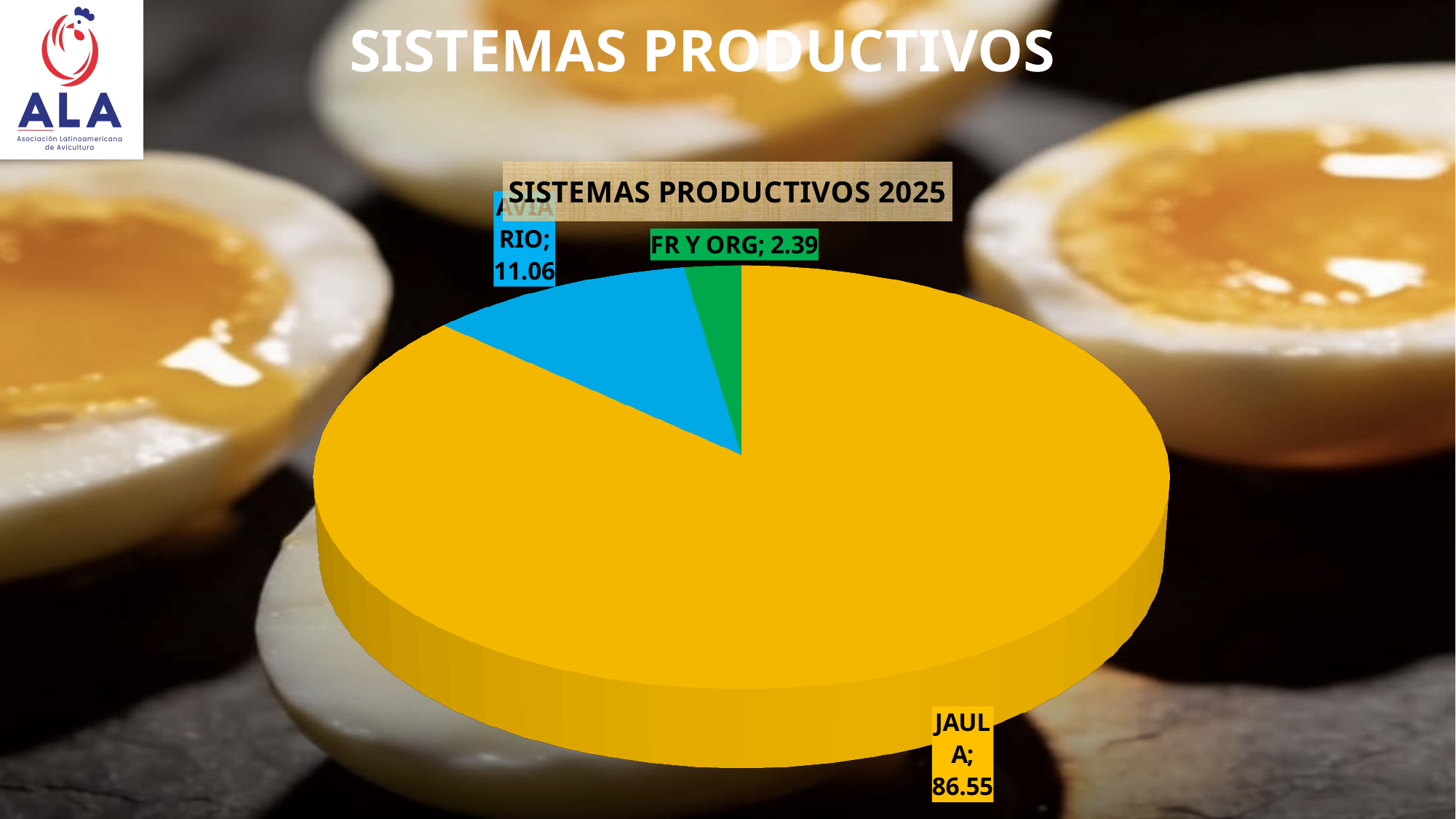
What kind of chart is shown on the slide? Pie chart What colour is the JAULA slice in the pie chart? Yellow What is the value for JAULA in the pie chart? 86.55 How many categories are shown in the pie chart? 3 What is the value for FR Y ORG in the pie chart? 2.39 Which category has the smallest slice in the pie chart? FR Y ORG What is the title of the chart? SISTEMAS PRODUCTIVOS 2025 Which is larger, the value for AVIARIO or the value for FR Y ORG? AVIARIO Which category has the largest slice in the pie chart? JAULA What is the value for AVIARIO in the pie chart? 11.06 What is the difference between the values for JAULA and AVIARIO? 75.49 What is the difference between the values for AVIARIO and FR Y ORG? 8.67